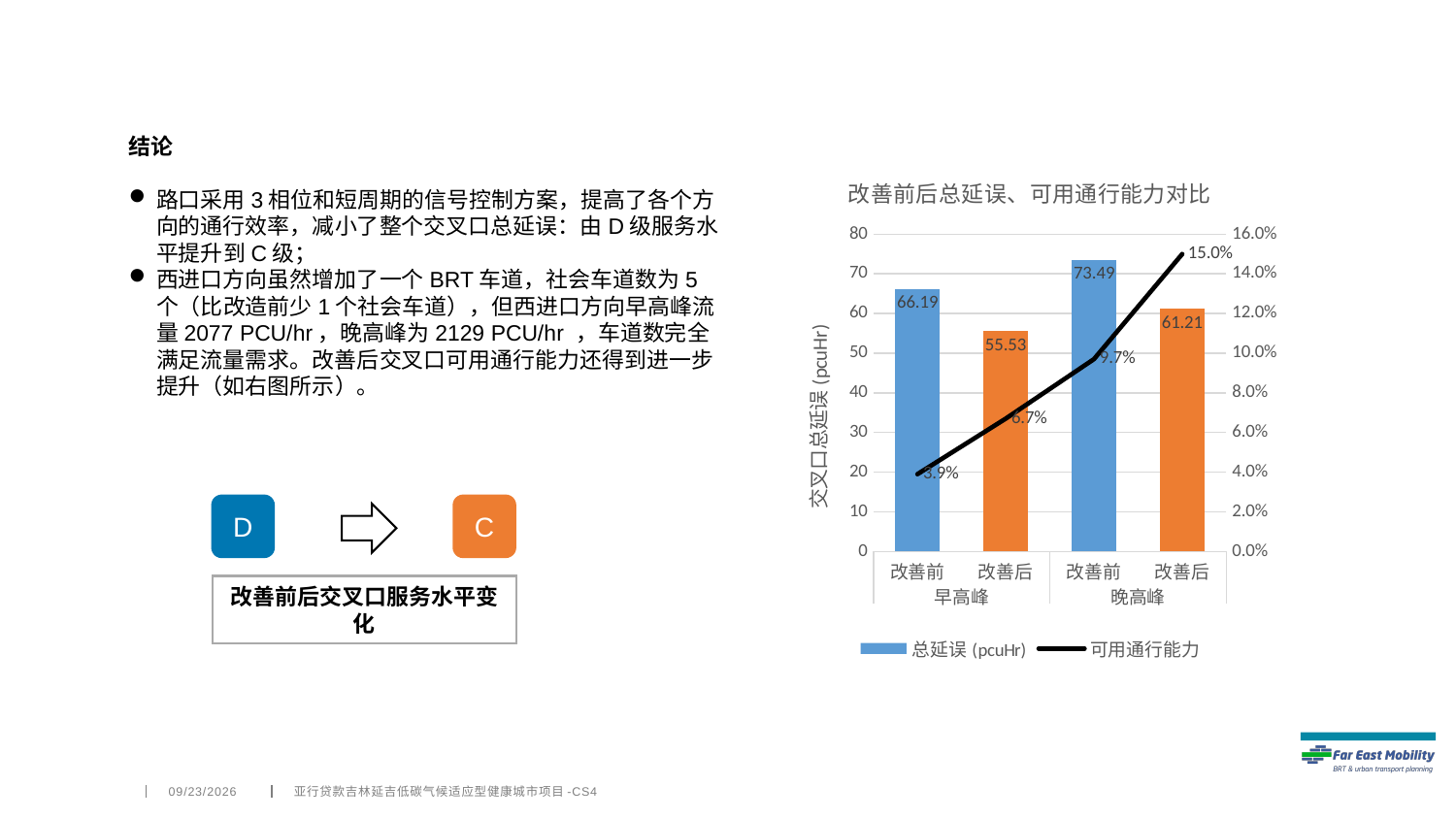
What is the 总延误 (pcuHr) value for 改善后 in the 晚高峰 group? 61.21 Does the 可用通行能力 line rise or fall from left to right? rise What is the difference in 总延误 (pcuHr) between 改善前 and 改善后 in the 早高峰 group? 10.66 What is the title of the chart? 改善前后总延误、可用通行能力对比 Which bar has the lowest 总延误 (pcuHr) value? 早高峰 改善后 What is the 可用通行能力 value for 改善前 in the 早高峰 group? 3.9% How many series does the legend list? 2 What is the 总延误 (pcuHr) value for 改善前 in the 早高峰 group? 66.19 Which bar has the highest 总延误 (pcuHr) value? 晚高峰 改善前 Which is larger: the 总延误 (pcuHr) for 改善后 in 早高峰 or 改善后 in 晚高峰? 改善后 in 晚高峰 What is the 可用通行能力 value for 改善后 in the 晚高峰 group? 15.0% What is the difference in 总延误 (pcuHr) between 改善前 and 改善后 in the 晚高峰 group? 12.28